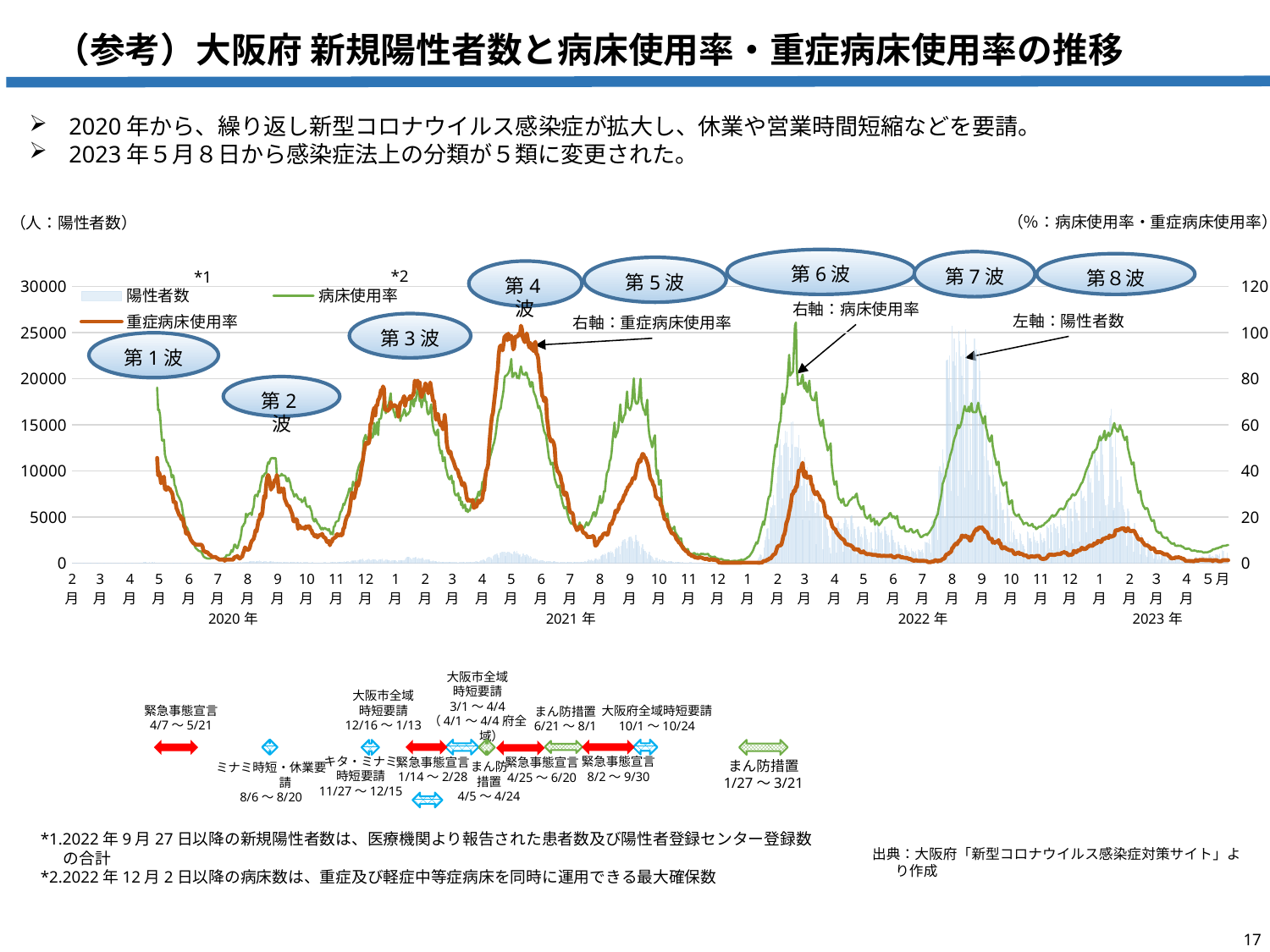
Is the peak value of 重症病床使用率 during 第7波 greater or less than 20? less Is the peak value of 陽性者数 during 第7波 greater or less than 20000? greater Which series is plotted on the left axis (左軸)? 陽性者数 In which wave does 陽性者数 reach its highest peak? 第7波 What kind of chart is shown on the slide? A combination chart with a bar series (陽性者数) and two line series Is the peak value of 病床使用率 during 第6波 greater or less than 80? greater Which is larger: the peak of 重症病床使用率 in 第4波 or in 第6波? 第4波 How many waves (第1波 to 第8波) are labelled on the chart? 8 How many series does the chart legend list? 3 What is the highest tick value shown on the right axis of the chart? 120